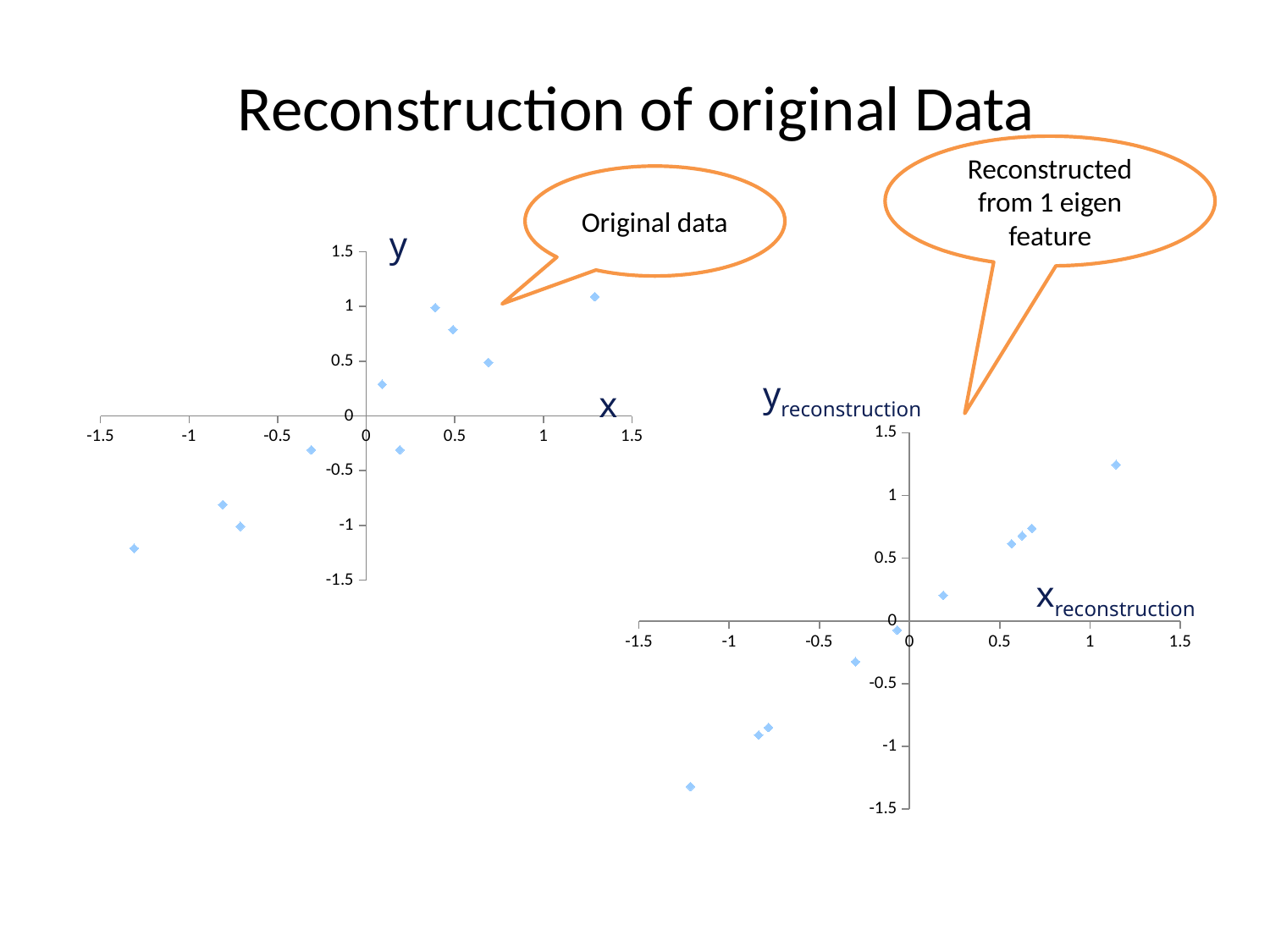
In the left chart (Original data), is the x value of the rightmost point greater or less than 1? greater In the left chart (Original data), is the y value of the lowest point greater or less than -1? less In the left chart (Original data), do the y values generally rise or fall as x increases? rise In the right chart (Reconstructed from 1 eigen feature), is the y value of the highest point greater or less than 1? greater What kind of chart is the right chart labelled "Reconstructed from 1 eigen feature"? scatter chart What is the label of the horizontal axis of the right chart? x reconstruction What is the maximum value shown on the vertical axis of the left chart (Original data)? 1.5 What kind of chart is the left chart labelled "Original data"? scatter chart In the left chart (Original data), how many data points are plotted? 10 In the right chart (Reconstructed from 1 eigen feature), how many data points are plotted? 10 In the right chart (Reconstructed from 1 eigen feature), do the y values generally rise or fall as x increases? rise